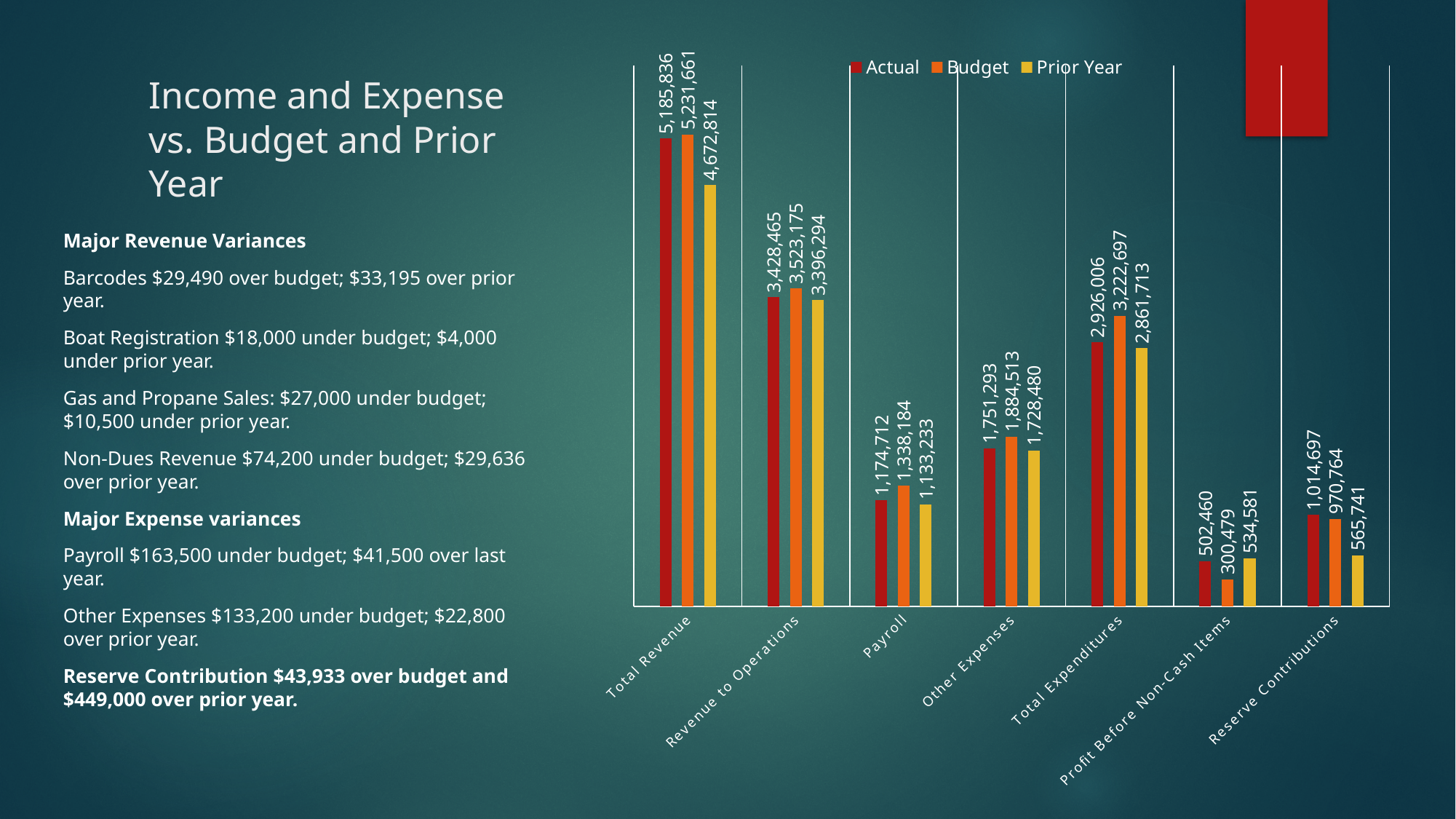
What kind of chart is shown on the slide? Bar chart What is the Actual value for Total Revenue? 5,185,836 Which category has the lowest Budget value? Profit Before Non-Cash Items What is the Prior Year value for Reserve Contributions? 565,741 How many series does the chart legend list? 3 What is the difference between the Budget and Actual values for Payroll? 163,472 What is the Budget value for Payroll? 1,338,184 What is the Budget value for Profit Before Non-Cash Items? 300,479 How many categories are shown on the x axis of the chart? 7 Which category has the highest Actual value? Total Revenue For Profit Before Non-Cash Items, which is larger: the Actual value or the Budget value? Actual What is the difference between the Actual and Prior Year values for Reserve Contributions? 448,956